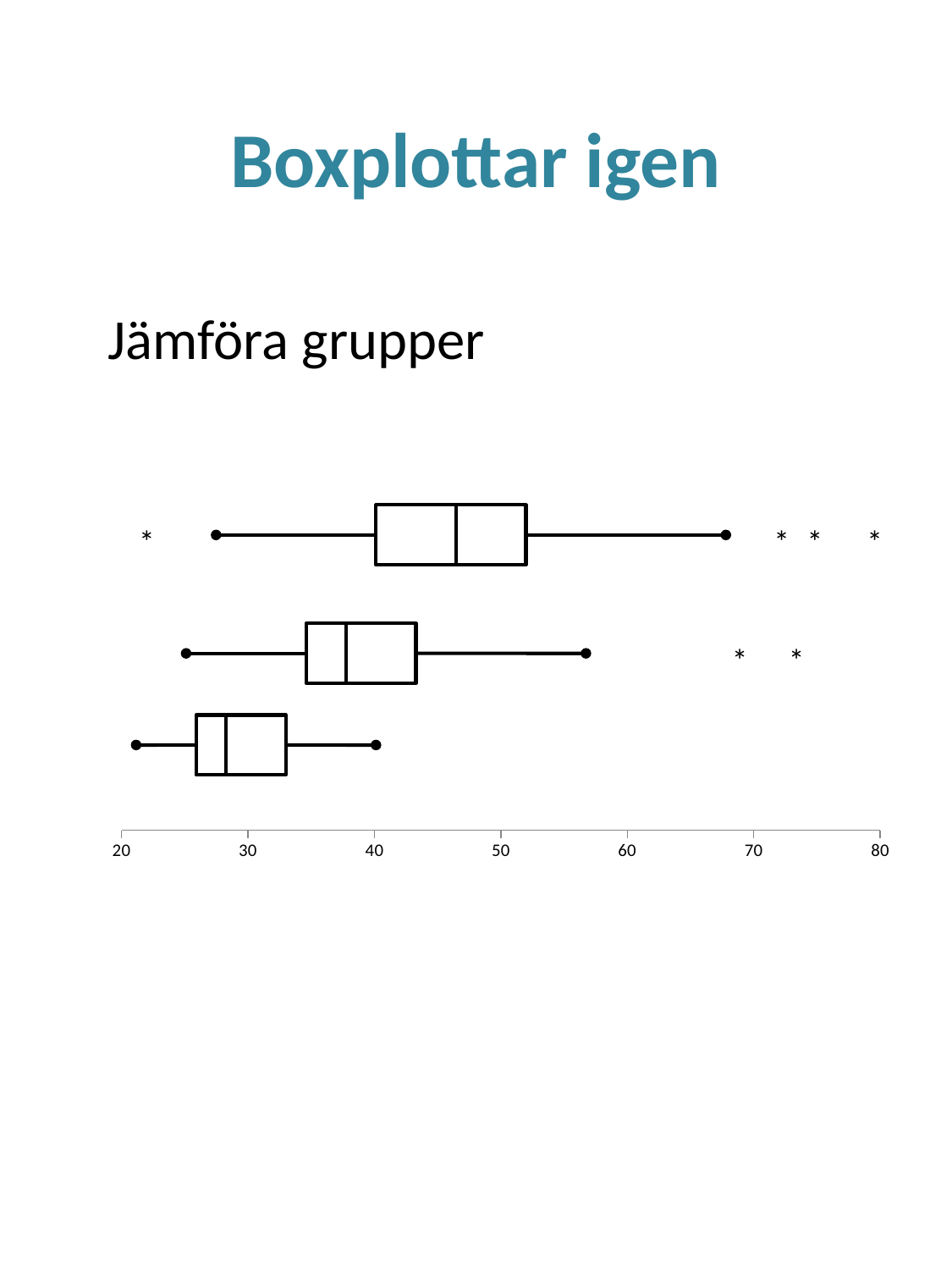
Which box plot has the lowest median: the top, middle or bottom one? Bottom How many outliers (asterisks) are marked for the top box plot? 4 How many box plots are drawn on the chart? 3 Is the median of the bottom box plot greater or less than 30? less Do the medians rise or fall going from the top box plot to the bottom box plot? fall How many outliers (asterisks) are marked for the middle box plot? 2 What kind of chart is shown on the slide? Box plot Is the median of the middle box plot greater or less than 40? less What is the title of the slide containing the box plots? Boxplottar igen Is the median of the top box plot greater or less than 40? greater Which box plot has the highest median: the top, middle or bottom one? Top